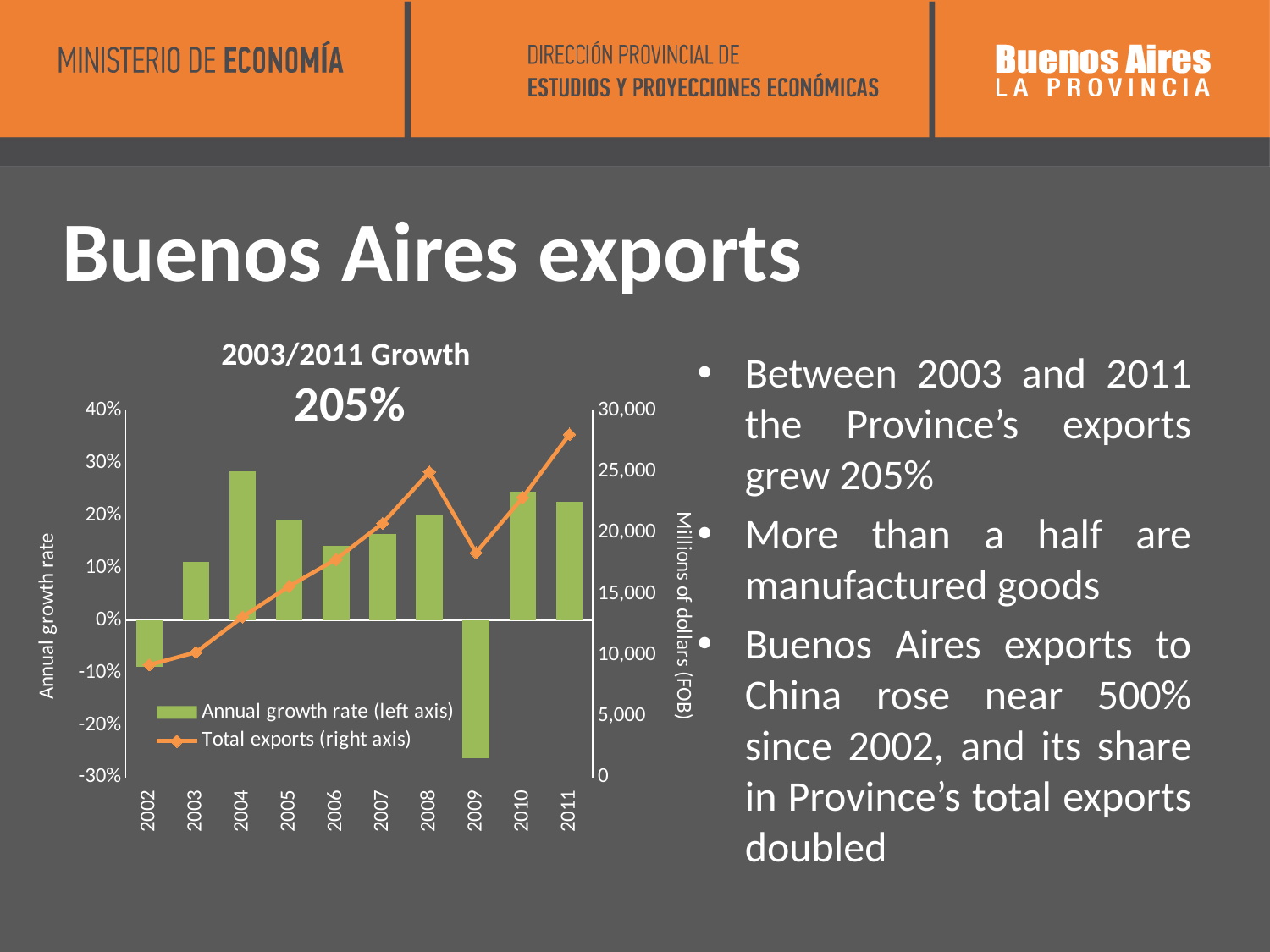
What kind of chart is shown on the slide? Combined bar and line chart Which year has the highest annual growth rate bar? 2004 Which year has the lowest annual growth rate bar? 2009 Which year has the larger total exports value, 2008 or 2009? 2008 Is the total exports value for 2011 greater or less than 25,000? greater Which year has the lowest total exports value on the line? 2002 Is the annual growth rate for 2009 greater or less than 0%? less How many years are shown on the x axis of the chart? 10 Is the annual growth rate for 2004 greater or less than 20%? greater Which year has the highest total exports value on the line? 2011 What growth figure is shown in the chart title for 2003/2011? 205% How many series does the chart legend list? 2